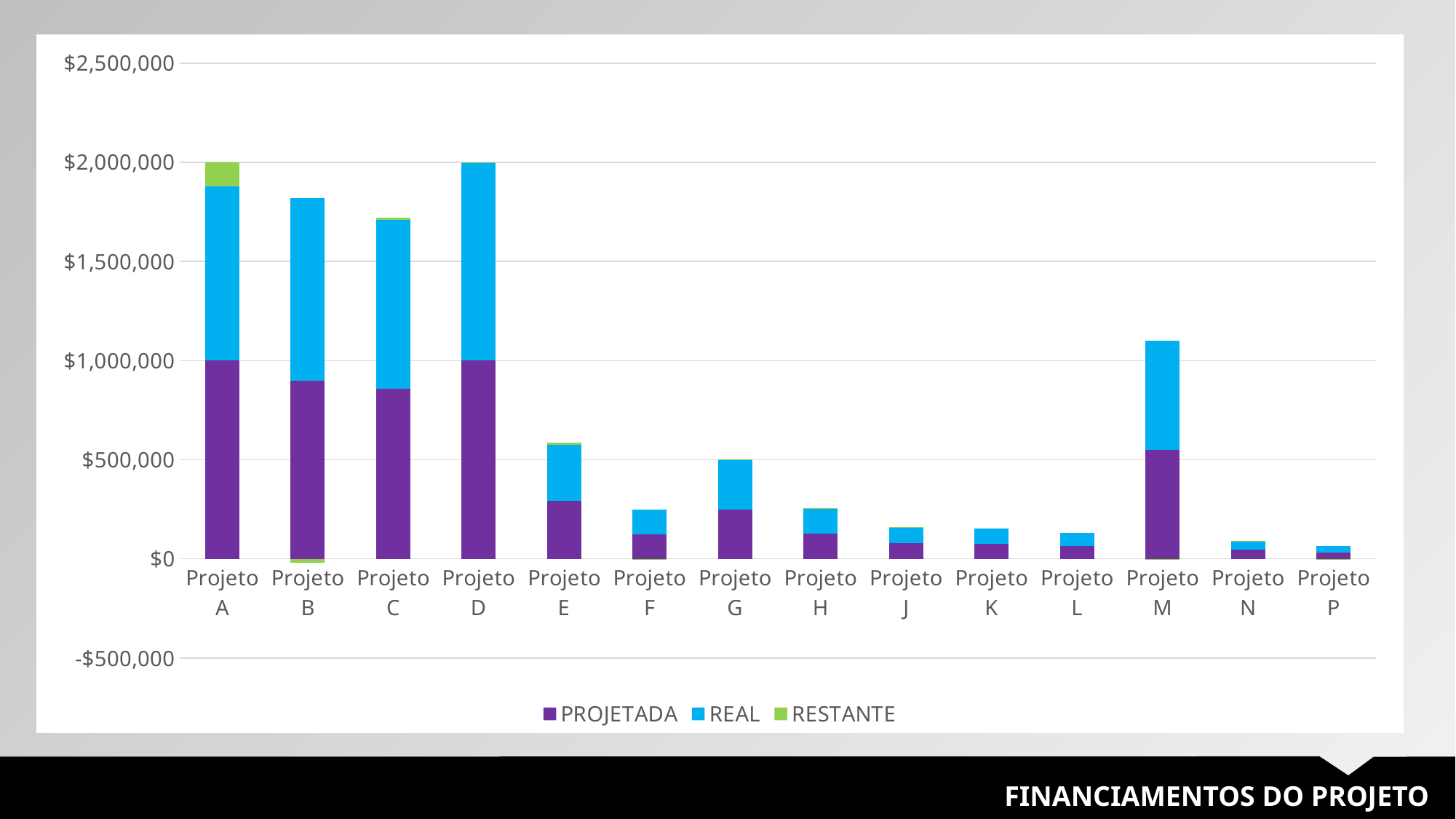
Which colour represents the REAL series? blue Is the total for Projeto F greater or less than $500,000? less What is the total height of the stacked bar for Projeto D? $2,000,000 How many projects (categories) are shown on the x axis? 14 How many series does the legend list? 3 What kind of chart is shown on the slide? bar chart Which has the larger total bar, Projeto M or Projeto G? Projeto M What are the three series named in the legend? PROJETADA, REAL, RESTANTE Is the total for Projeto M greater or less than $1,000,000? greater Is the total for Projeto B greater or less than $1,500,000? greater What is the PROJETADA value for Projeto A? $1,000,000 Which project has the lowest total bar? Projeto P